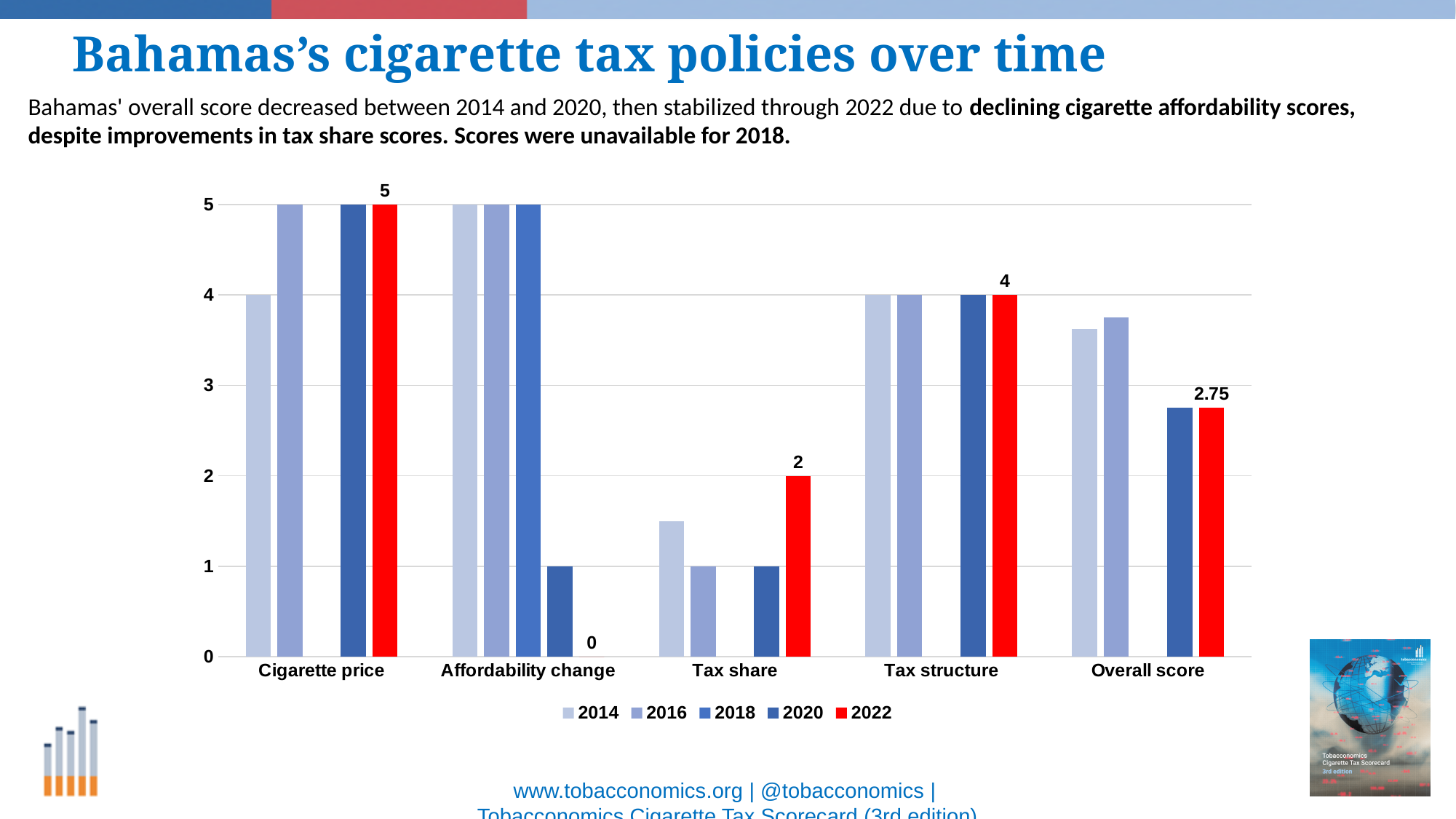
What is the 2022 value for Tax share? 2 What is the 2022 value for Affordability change? 0 Is the 2014 value for Tax share greater or less than 2? less How many series does the legend list? 5 What is the difference between the 2022 values for Tax structure and Tax share? 2 Among the 2022 bars, which category has the lowest value? Affordability change Which is larger in 2022: Tax share or Tax structure? Tax structure Is the 2014 value for Overall score greater or less than 3? greater What kind of chart is shown on the slide? bar chart What is the 2022 value for Overall score? 2.75 What is the 2022 value for Cigarette price? 5 How many categories are shown on the x axis? 5